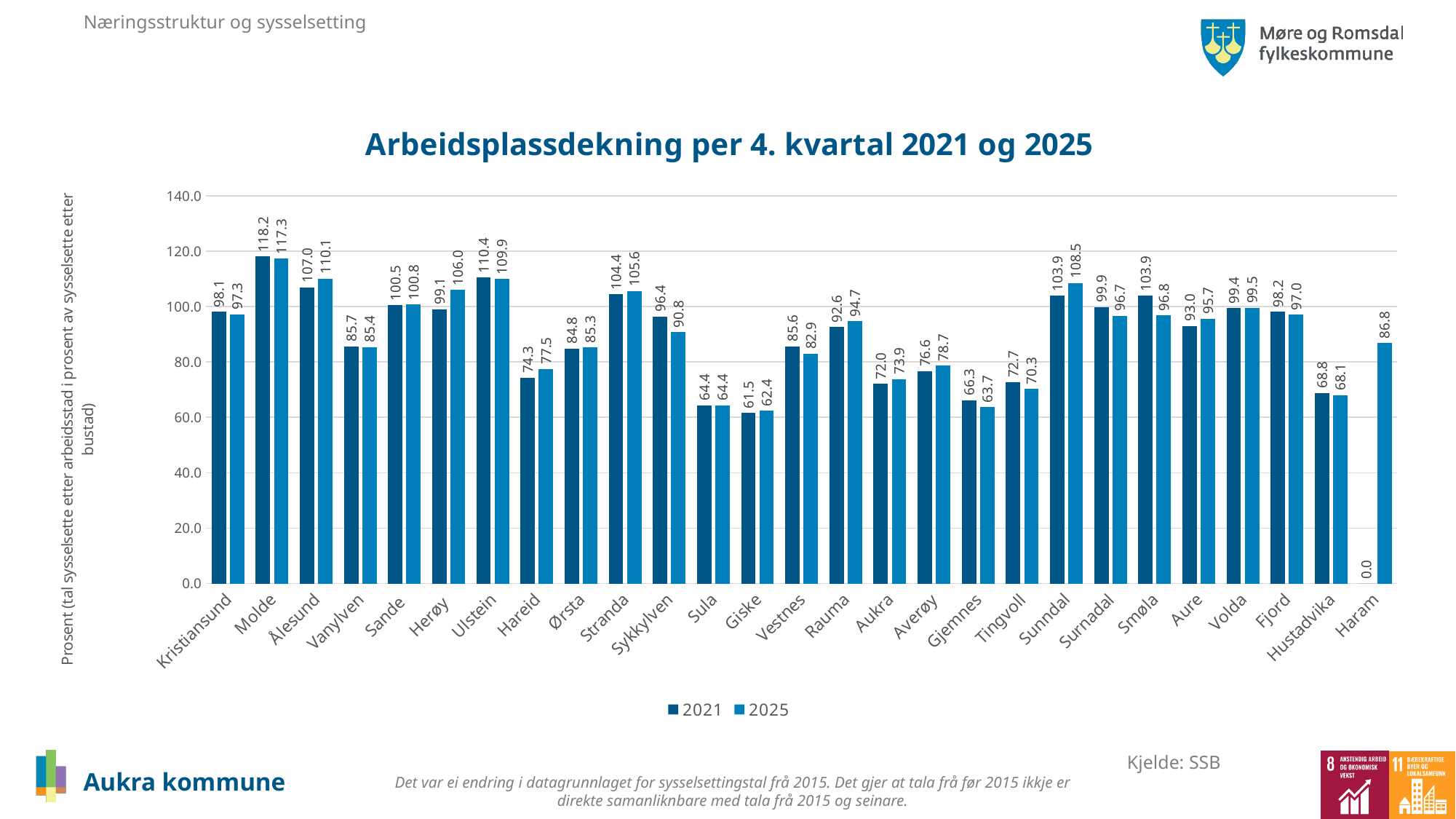
How many series does the legend list? 2 Which municipality has the lowest 2025 value? Giske Is the 2021 value for Ulstein greater or less than 100.0? greater What is the 2025 value for Sunndal? 108.5 What is the 2025 value for Haram? 86.8 What is the title of the chart? Arbeidsplassdekning per 4. kvartal 2021 og 2025 Which municipality has the highest 2025 value? Molde Which is larger for Sykkylven, the 2021 value or the 2025 value? 2021 What is the difference between the 2021 and 2025 values for Herøy? 6.9 What is the 2021 value for Aukra? 72.0 What kind of chart is shown on the slide? Bar chart How many municipalities are shown on the x axis? 27